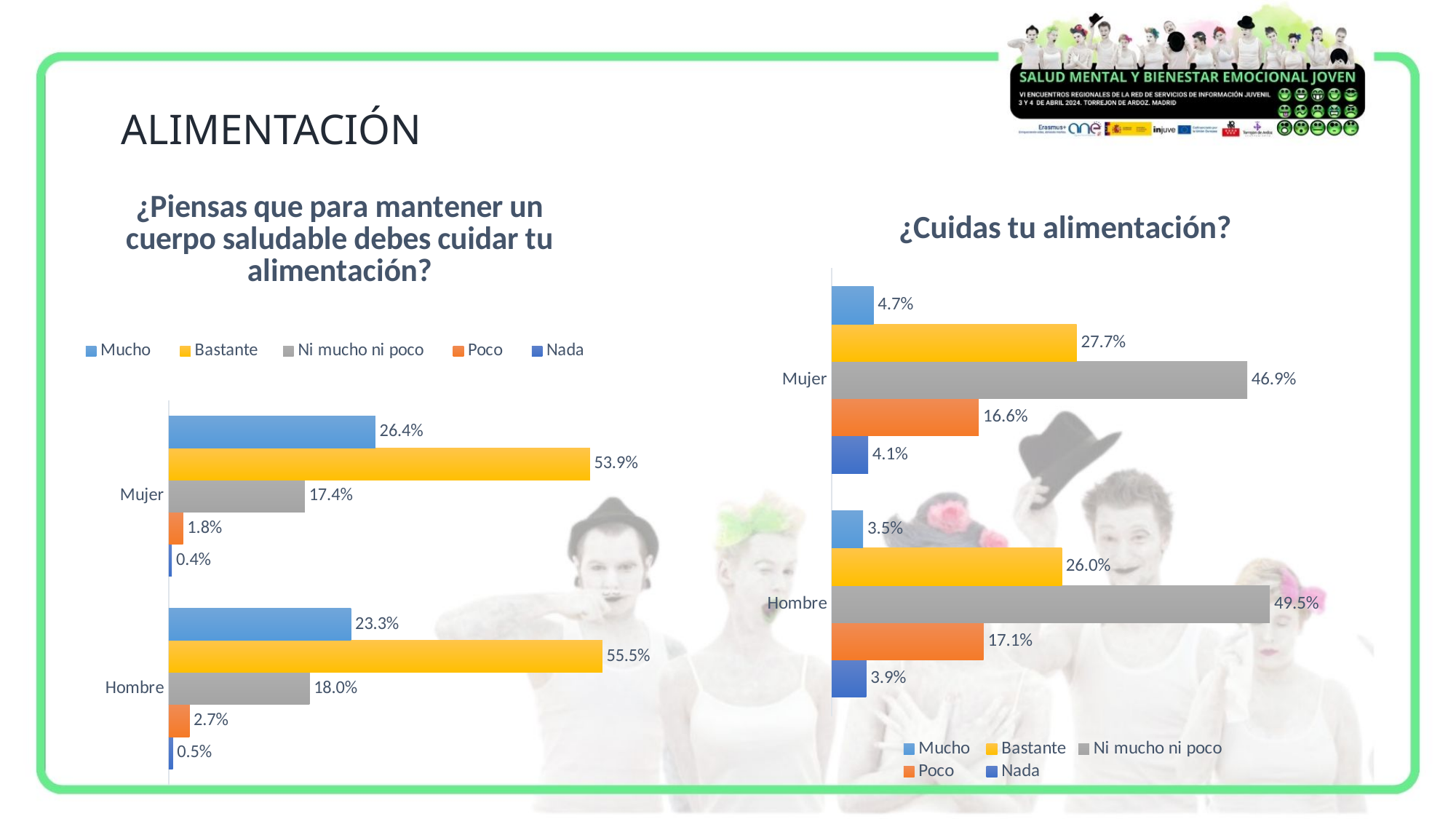
In the chart titled '¿Cuidas tu alimentación?', which is larger: 'Mucho' for Mujer or 'Mucho' for Hombre? Mucho for Mujer In the chart titled '¿Cuidas tu alimentación?', what is the value for 'Ni mucho ni poco' for Hombre? 49.5% What kind of chart is the chart titled '¿Piensas que para mantener un cuerpo saludable debes cuidar tu alimentación?'? Bar chart How many series does the legend of the chart titled '¿Cuidas tu alimentación?' list? 5 In the chart titled '¿Piensas que para mantener un cuerpo saludable debes cuidar tu alimentación?', which series has the lowest value for Hombre? Nada In the chart titled '¿Piensas que para mantener un cuerpo saludable debes cuidar tu alimentación?', what is the difference between the 'Bastante' values for Hombre and Mujer? 1.6% In the chart titled '¿Cuidas tu alimentación?', what is the difference between the 'Bastante' values for Mujer and Hombre? 1.7% In the chart titled '¿Piensas que para mantener un cuerpo saludable debes cuidar tu alimentación?', what is the value for 'Mucho' for Hombre? 23.3% In the chart titled '¿Piensas que para mantener un cuerpo saludable debes cuidar tu alimentación?', what colour are the 'Poco' bars? Orange In the chart titled '¿Cuidas tu alimentación?', what is the value for 'Poco' for Mujer? 16.6% In the chart titled '¿Cuidas tu alimentación?', which series has the highest value for Mujer? Ni mucho ni poco In the chart titled '¿Piensas que para mantener un cuerpo saludable debes cuidar tu alimentación?', what is the value for 'Bastante' for Mujer? 53.9%